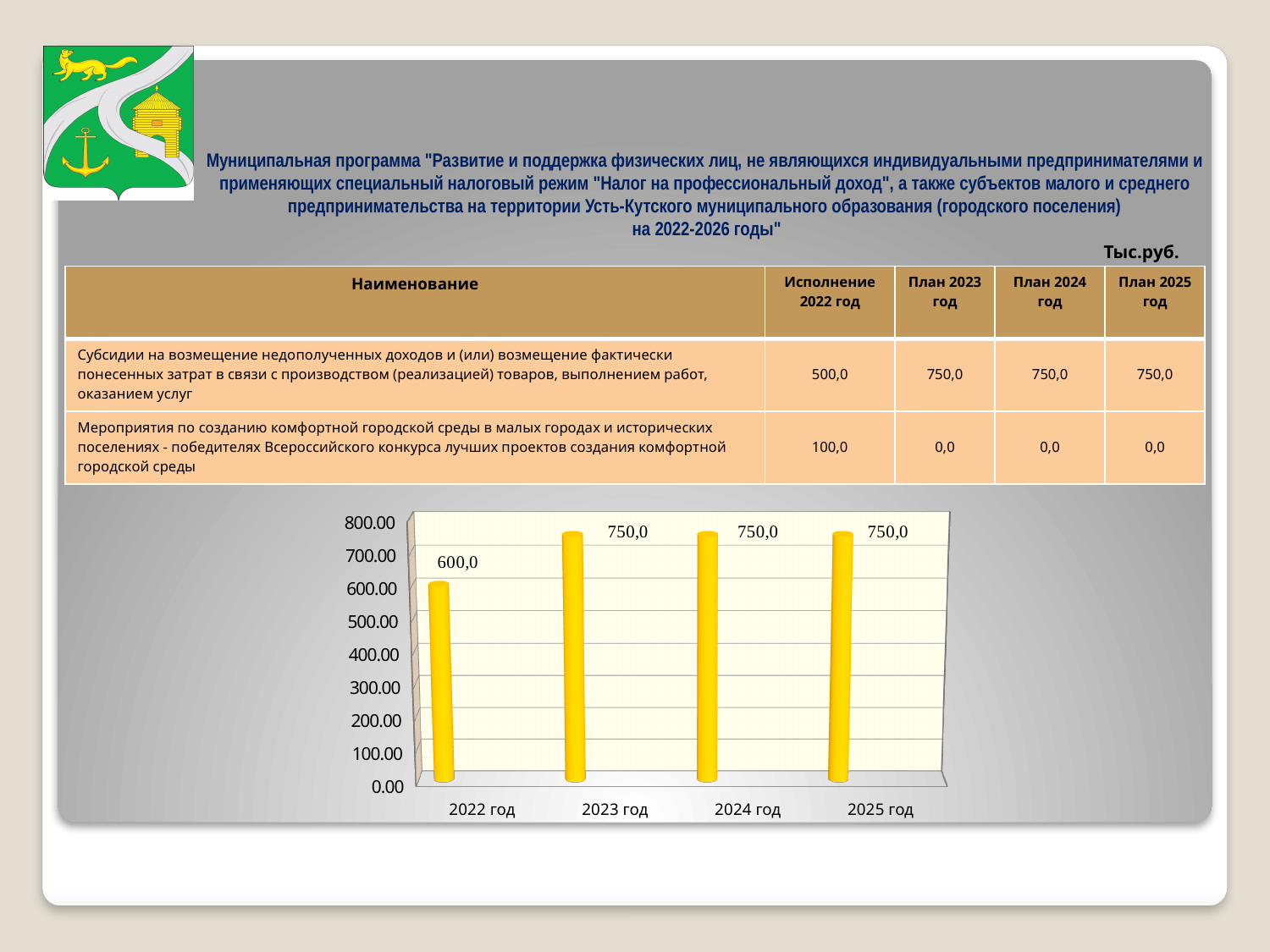
What is the value for 2025 год in the chart? 750,0 What is the difference between the values for 2023 год and 2022 год in the chart? 150,0 Which year has the lowest value in the chart? 2022 год What type of chart is shown on the slide? bar chart Is the value for 2022 год in the chart greater or less than 700.00? less What is the highest tick value shown on the vertical axis of the chart? 800.00 Do the values in the chart rise or fall from 2022 год to 2023 год? rise How many bars are shown in the chart? 4 What is the value for 2022 год in the chart? 600,0 Which is larger in the chart, the value for 2022 год or the value for 2024 год? 2024 год Is the value for 2024 год in the chart greater or less than 700.00? greater What is the value for 2023 год in the chart? 750,0